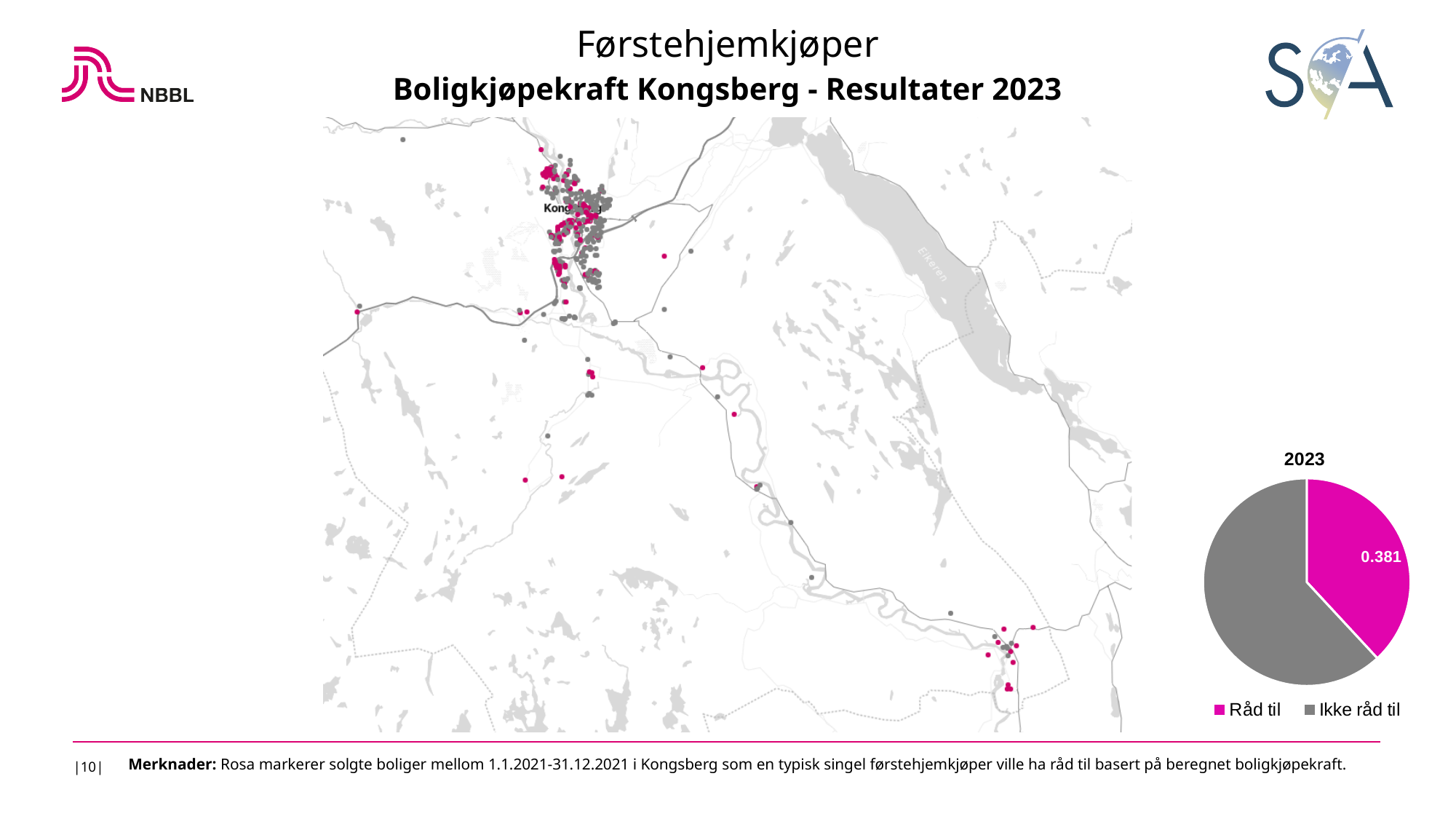
What value is printed on the "Råd til" slice of the pie chart? 0.381 Which category has the largest slice in the pie chart? Ikke råd til What is the title of the pie chart? 2023 Which colour represents "Råd til" in the pie chart? pink What share of the pie chart does the "Råd til" slice represent? 0.381 Which slice of the pie chart is larger, "Råd til" or "Ikke råd til"? Ikke råd til How many entries does the legend of the pie chart list? 2 Which category has the smallest slice in the pie chart? Råd til What kind of chart is shown on the right side of the slide? pie chart How many slices does the pie chart have? 2